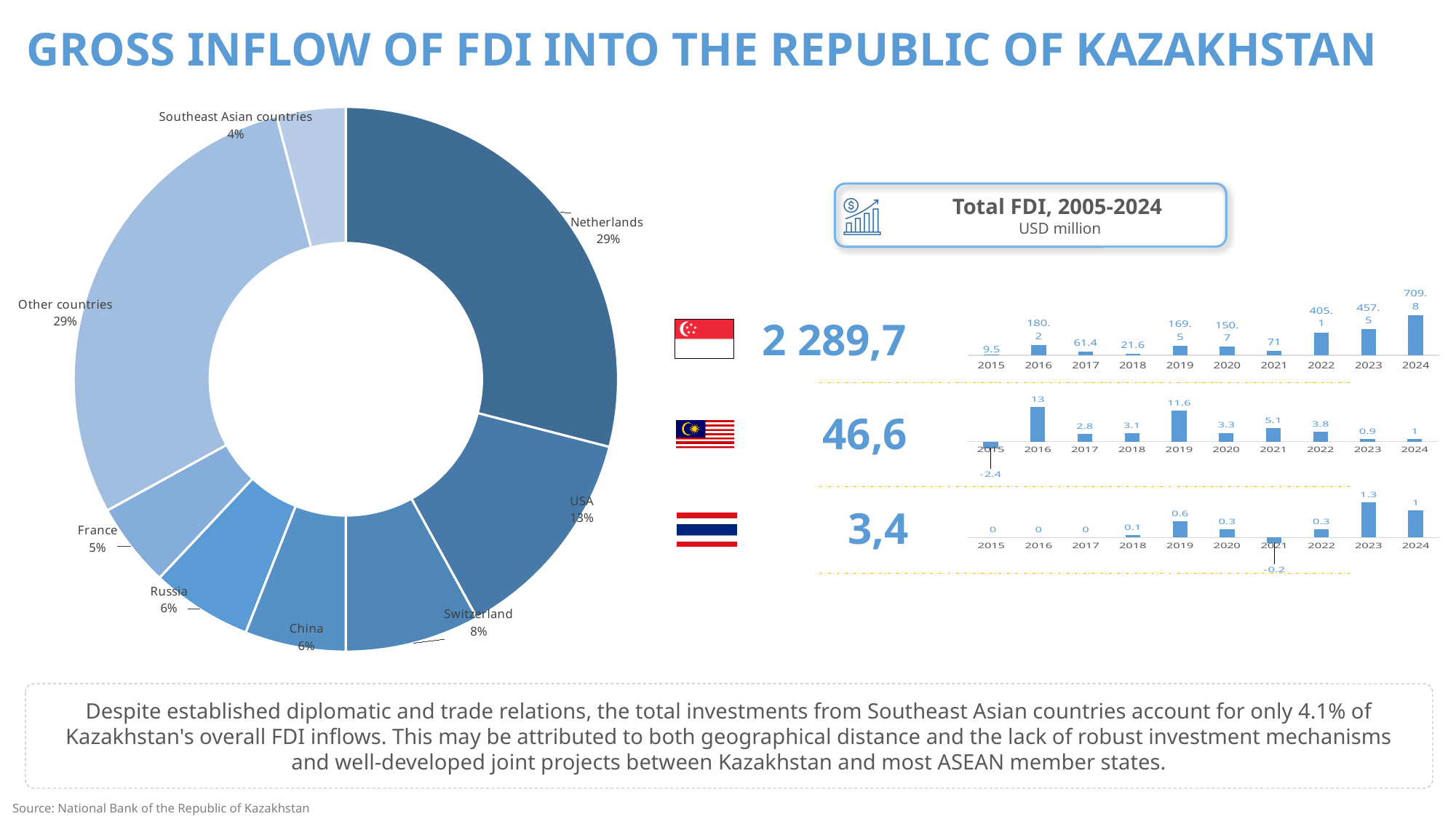
In the middle bar chart on the right, which year has the highest value? 2016 In the donut chart, what share of FDI inflow comes from Southeast Asian countries? 4% In the middle bar chart on the right, what is the value for 2015? -2.4 In the donut chart, what is the difference between the shares of USA and France? 8% What kind of chart is shown on the left of the slide? Donut (pie) chart In the donut chart, which is larger, the share for USA or the share for Switzerland? USA In the donut chart, which named country has the largest share? Netherlands In the donut chart, what share of FDI inflow comes from the Netherlands? 29% How many years are shown on the x axis of each bar chart on the right? 10 In the bottom bar chart on the right, what is the difference between the values for 2023 and 2024? 0.3 In the top bar chart on the right, what is the value for 2024? 709.8 In the top bar chart on the right, which year has the lowest value? 2015